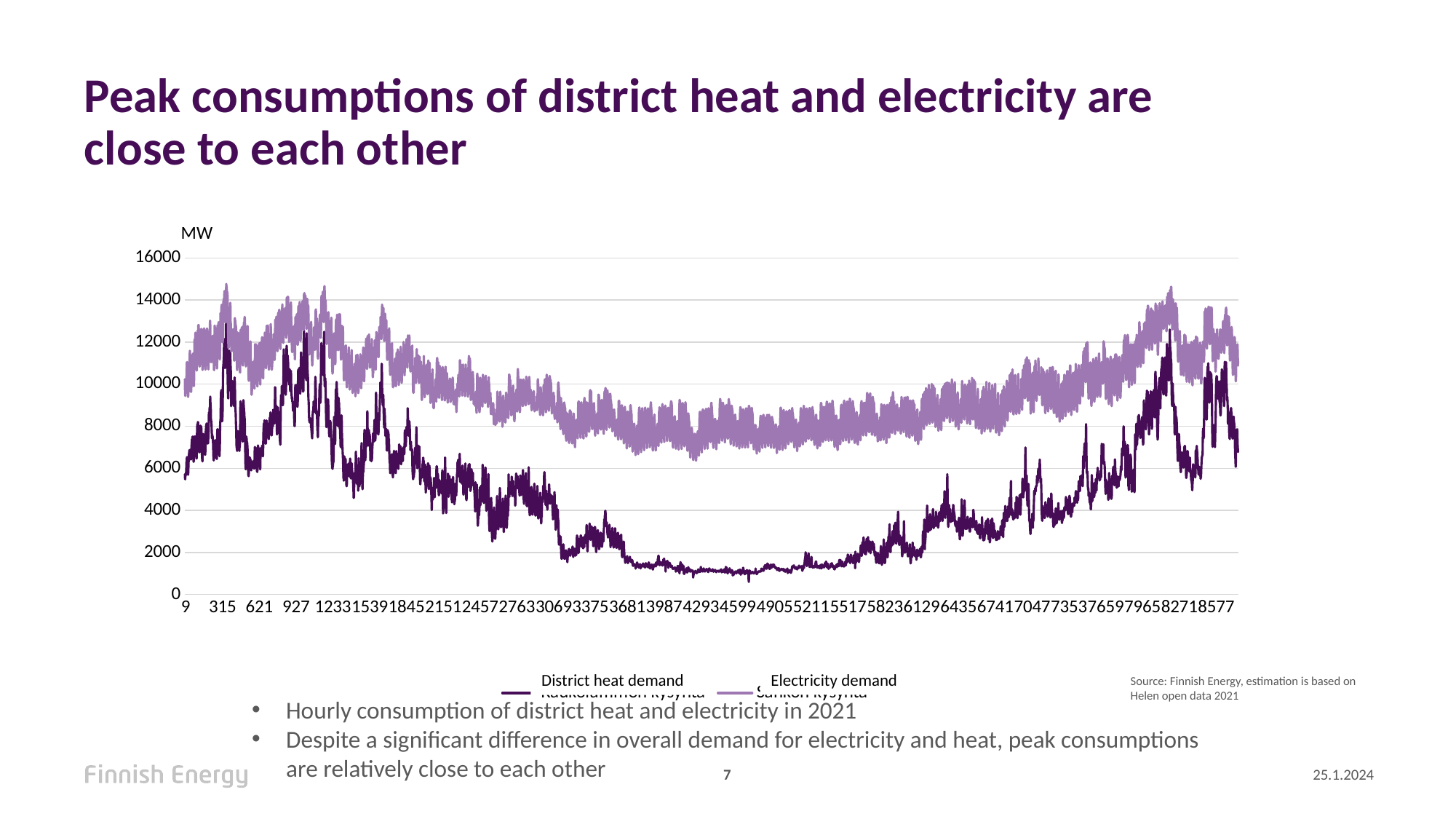
Is the District heat demand in the middle of the chart greater or less than 2000? less How many series does the chart's legend list? 2 What kind of chart is shown on the slide? line chart Does Electricity demand rise or fall from the middle of the chart to the end of the x axis? rise Is the peak value of Electricity demand greater or less than 14000? greater Which series reaches the lowest value on the chart? District heat demand What is the highest tick value shown on the chart's vertical axis? 16000 What are the two series named in the chart's legend? District heat demand and Electricity demand What unit is shown on the chart's vertical axis? MW Is the peak value of District heat demand greater or less than 12000? greater Which series is higher across the middle of the chart, District heat demand or Electricity demand? Electricity demand Does District heat demand rise or fall from the start of the x axis to the middle of the chart? fall